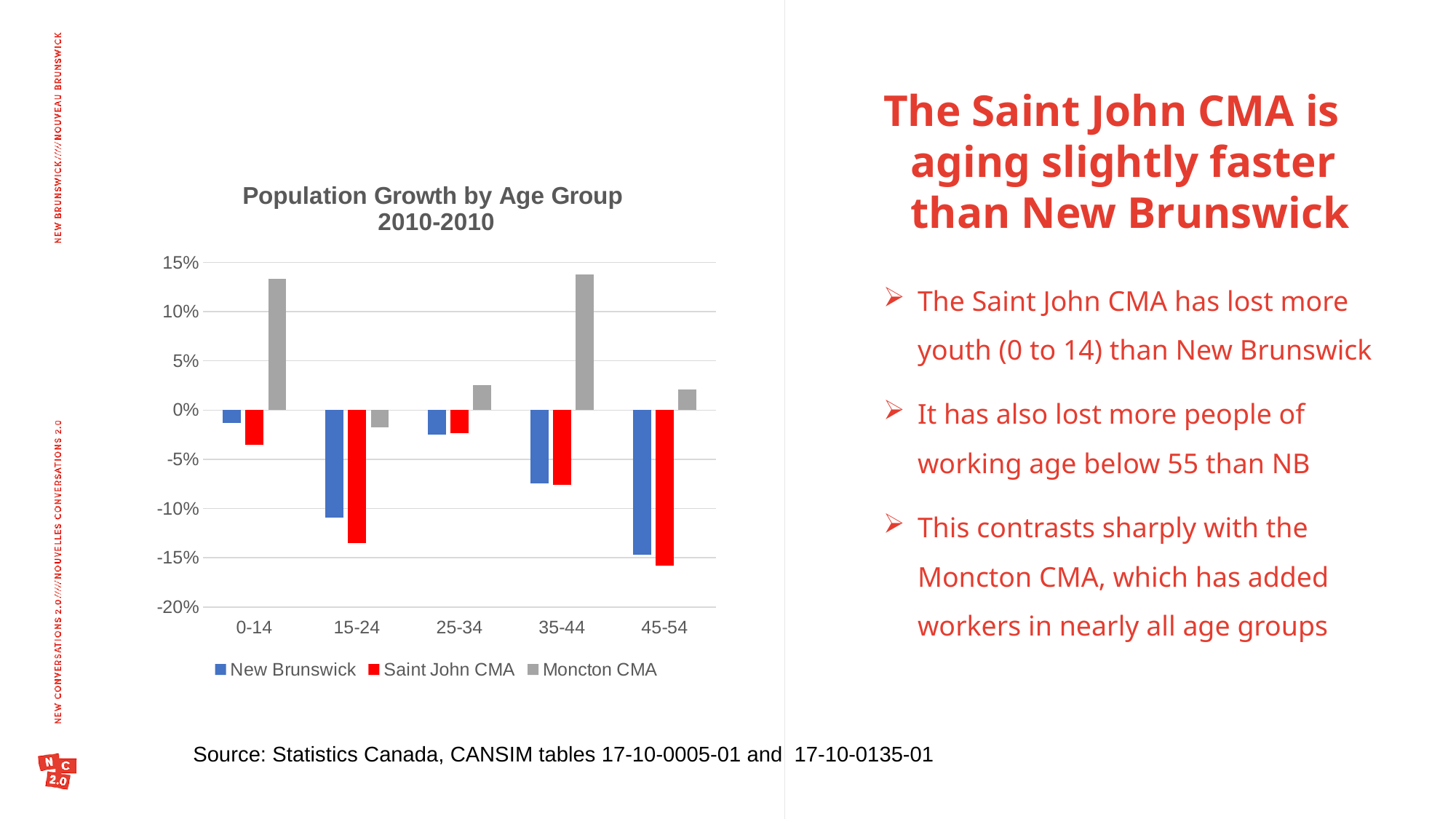
What type of chart is shown on the slide? Bar chart For the 15-24 age group, which is larger: the New Brunswick value or the Saint John CMA value? New Brunswick For which age group is the Saint John CMA value lowest? 45-54 For which age group is the Moncton CMA value lowest? 15-24 Is the Moncton CMA value for the 0-14 age group greater or less than 10%? greater For which age group is the New Brunswick value lowest? 45-54 How many age groups are shown on the x axis of the chart? 5 What is the title of the chart? Population Growth by Age Group 2010-2010 Is the Saint John CMA value for the 15-24 age group greater or less than -10%? less Is the New Brunswick value for the 45-54 age group greater or less than -10%? less How many series does the legend of the chart list? 3 Which series is shown in red in the chart? Saint John CMA